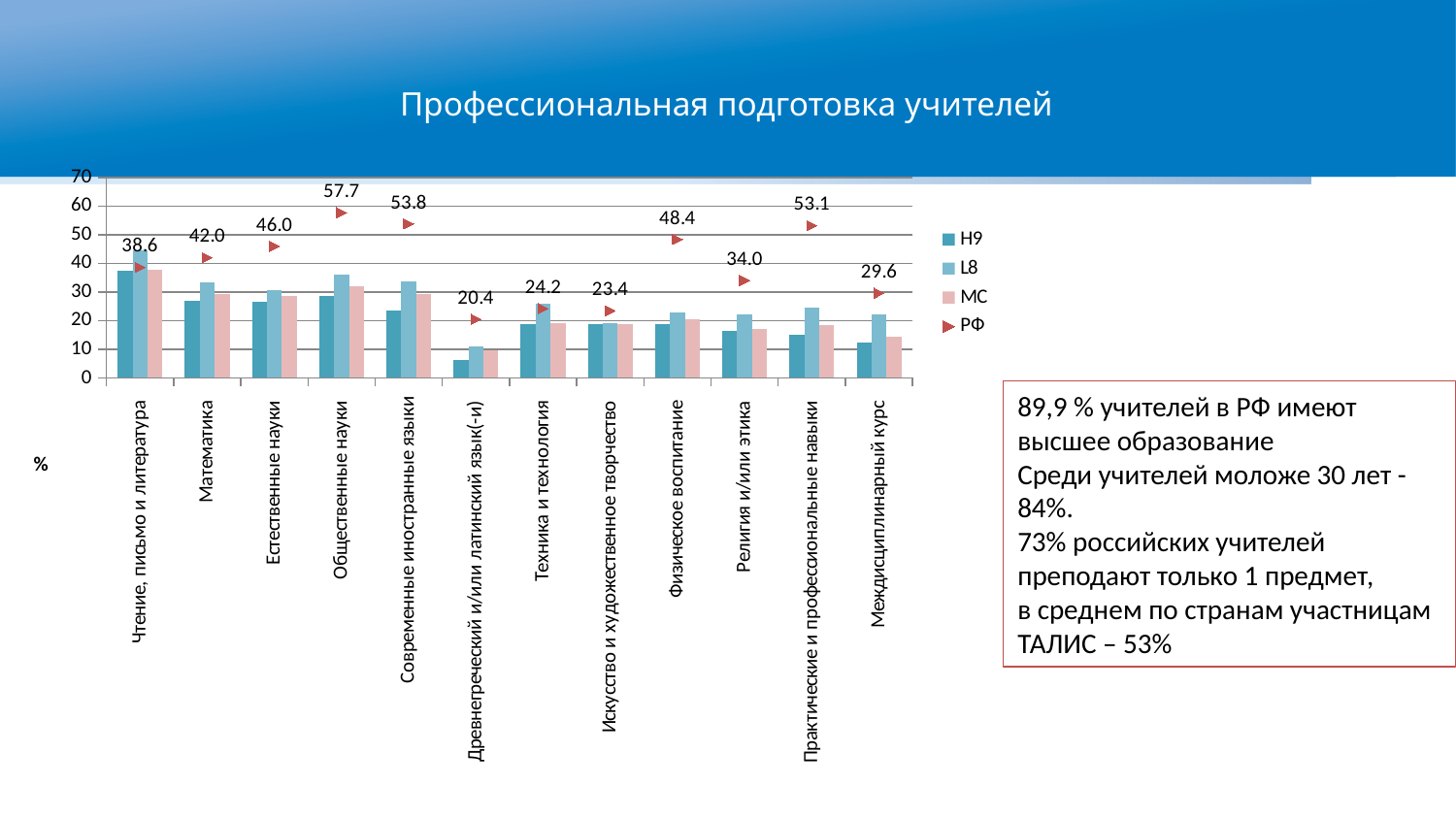
How many series does the legend list? 4 Is the H9 value for Чтение, письмо и литература greater or less than 30? greater Which category has the lowest РФ value? Древнегреческий и/или латинский язык(-и) What is the difference between the РФ values for Общественные науки and Древнегреческий и/или латинский язык(-и)? 37.3 What is the РФ value for Общественные науки? 57.7 What is the difference between the РФ values for Физическое воспитание and Религия и/или этика? 14.4 Which has the larger РФ value, Математика or Естественные науки? Естественные науки Is the L8 value for Древнегреческий и/или латинский язык(-и) greater or less than 20? less Which category has the highest РФ value? Общественные науки What is the РФ value for Физическое воспитание? 48.4 How many categories are shown on the x axis? 12 What is the РФ value for Древнегреческий и/или латинский язык(-и)? 20.4